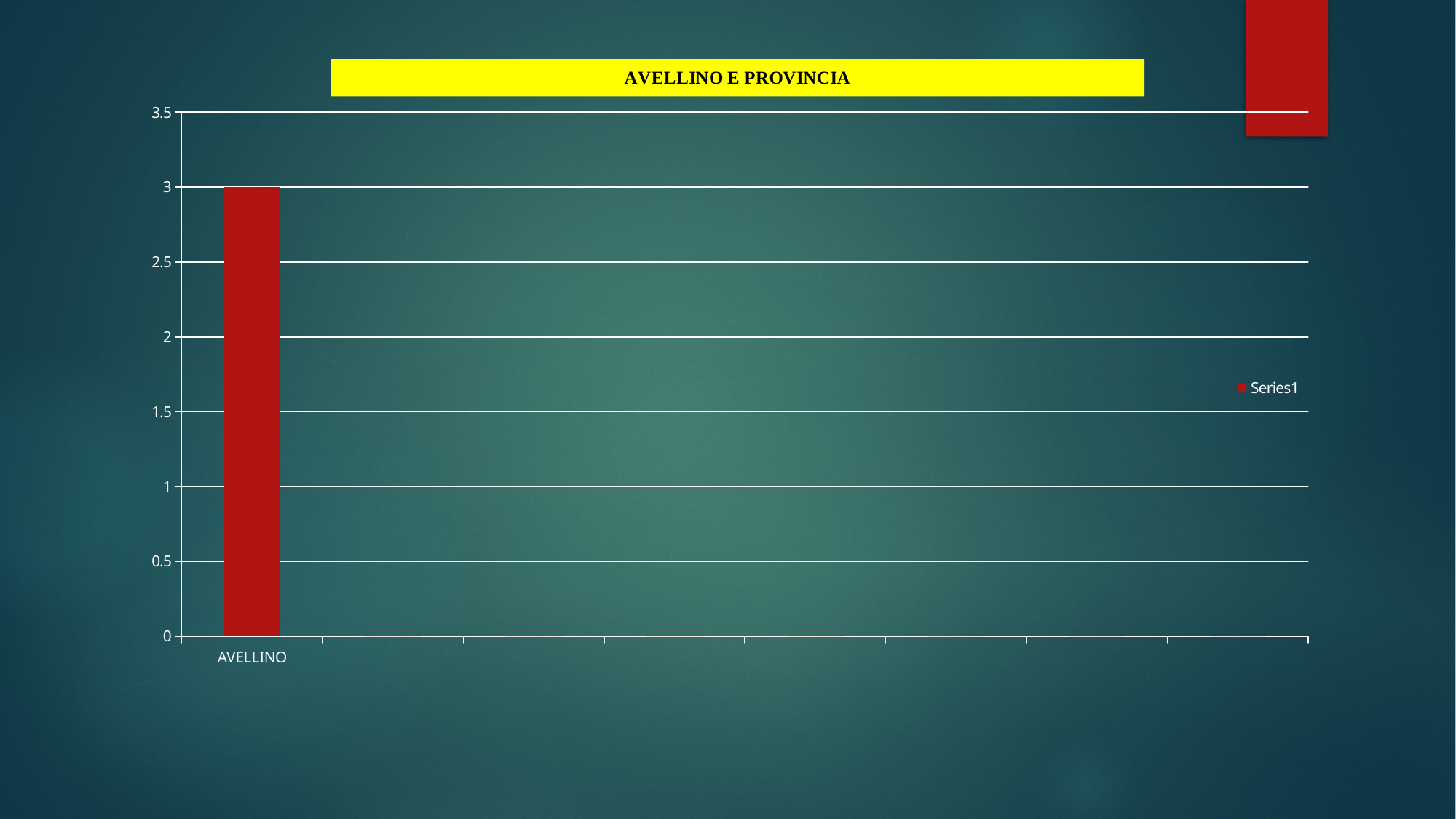
What is the name of the series shown in the legend? Series1 What is the title of the chart? AVELLINO E PROVINCIA Is the value for AVELLINO greater or less than 3.5? less How many labelled categories are plotted on the chart? 1 What kind of chart is shown on the slide? bar chart How many series does the legend list? 1 Is the value for AVELLINO greater or less than 2? greater What is the highest value shown on the vertical axis? 3.5 What is the value for AVELLINO? 3